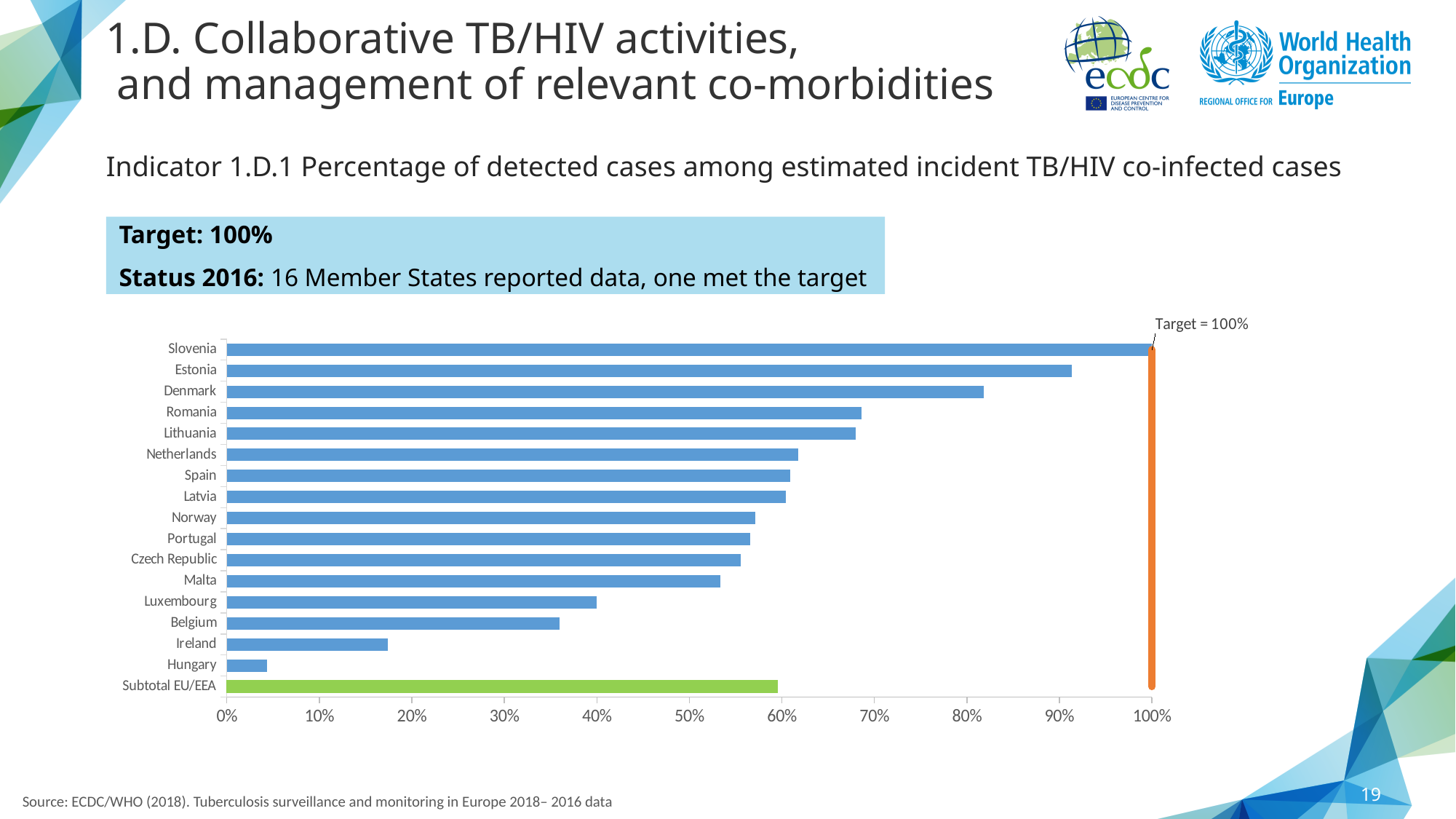
What kind of chart is shown on the slide? bar chart Is the value for Denmark greater or less than 80%? greater Is the value for Belgium greater or less than 40%? less What is the value for Slovenia? 100% Which country has the lowest percentage in the chart? Hungary Is the value for Ireland greater or less than 20%? less Which has a larger value, Belgium or Ireland? Belgium What target value is marked by the vertical orange line in the chart? Target = 100% Which has a larger value, Denmark or Romania? Denmark Which country has the highest percentage of detected cases among estimated incident TB/HIV co-infected cases? Slovenia How many bars are plotted in the chart, including the Subtotal EU/EEA bar? 17